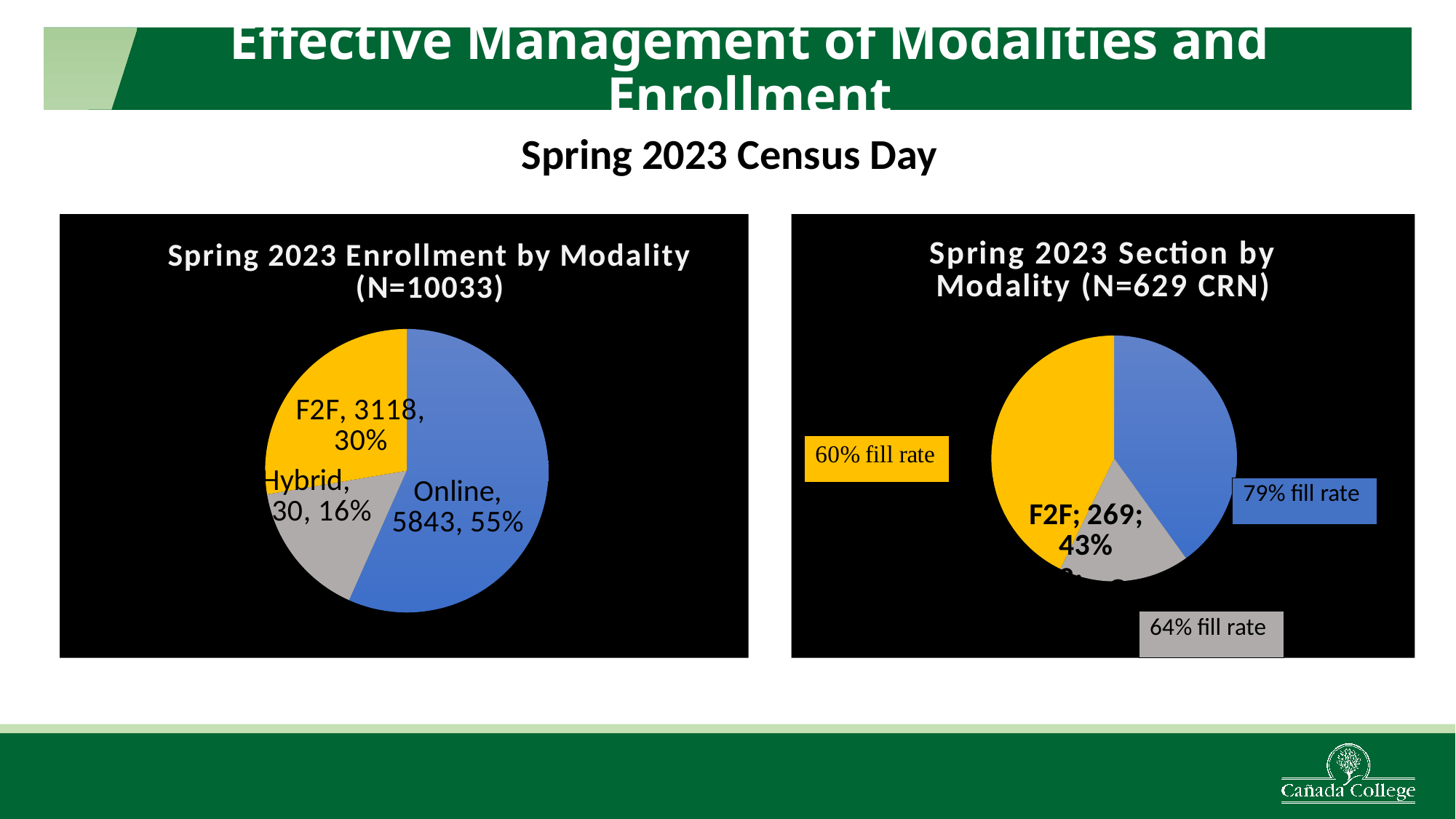
In the 'Spring 2023 Section by Modality' chart on the right, what fill rate is shown in the blue box next to the blue slice? 79% fill rate In the 'Spring 2023 Enrollment by Modality' chart, what is the difference between the Online and F2F enrollment values? 2725 In the 'Spring 2023 Enrollment by Modality' chart, what share of the pie does Hybrid represent? 16% In the 'Spring 2023 Enrollment by Modality' chart, which modality has the largest slice? Online In the 'Spring 2023 Enrollment by Modality' chart, what is the enrollment value for Online? 5843 In the 'Spring 2023 Enrollment by Modality' chart, what is the enrollment value for F2F? 3118 In the 'Spring 2023 Enrollment by Modality' chart, which modality has the smallest slice? Hybrid What type of chart is the 'Spring 2023 Enrollment by Modality' chart on the left? Pie chart In the 'Spring 2023 Section by Modality' chart on the right, what share of the pie does F2F represent? 43% In the 'Spring 2023 Section by Modality' chart on the right, how many sections are F2F? 269 In the 'Spring 2023 Enrollment by Modality' chart, what share of the pie does Online represent? 55% How many slices does the 'Spring 2023 Enrollment by Modality' pie chart have? 3